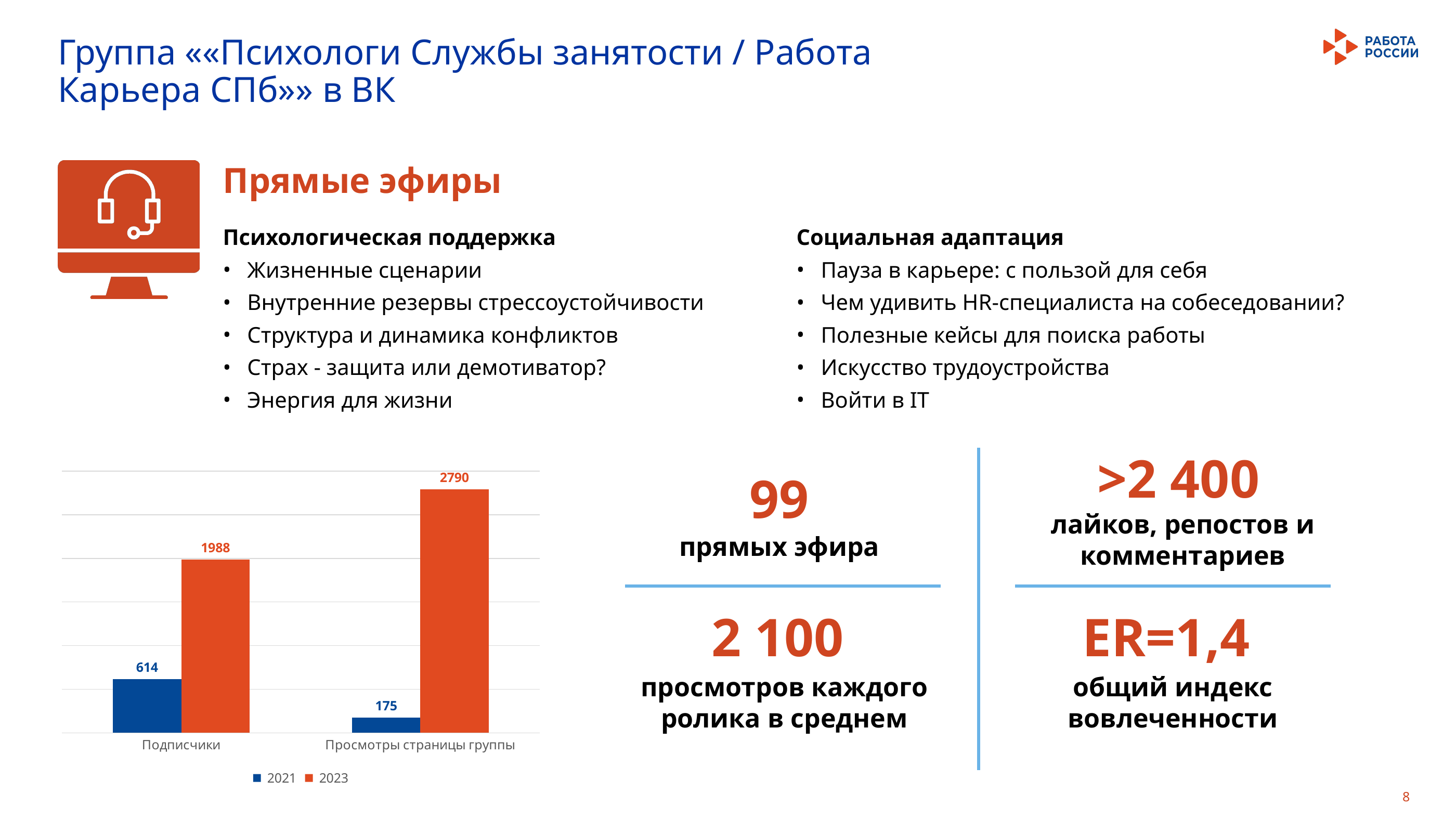
How many categories are shown on the x axis of the chart? 2 What is the value for Подписчики in the 2021 series? 614 What is the value for Просмотры страницы группы in the 2023 series? 2790 Which is larger: the 2021 value for Подписчики or the 2021 value for Просмотры страницы группы? Подписчики What is the difference between the 2023 and 2021 values for Просмотры страницы группы? 2615 How many series does the chart legend list? 2 Which category has the lowest value in the 2021 series? Просмотры страницы группы What is the difference between the 2023 and 2021 values for Подписчики? 1374 What is the value for Просмотры страницы группы in the 2021 series? 175 What is the value for Подписчики in the 2023 series? 1988 What kind of chart is shown on the slide? Bar chart Which category has the highest value in the 2023 series? Просмотры страницы группы